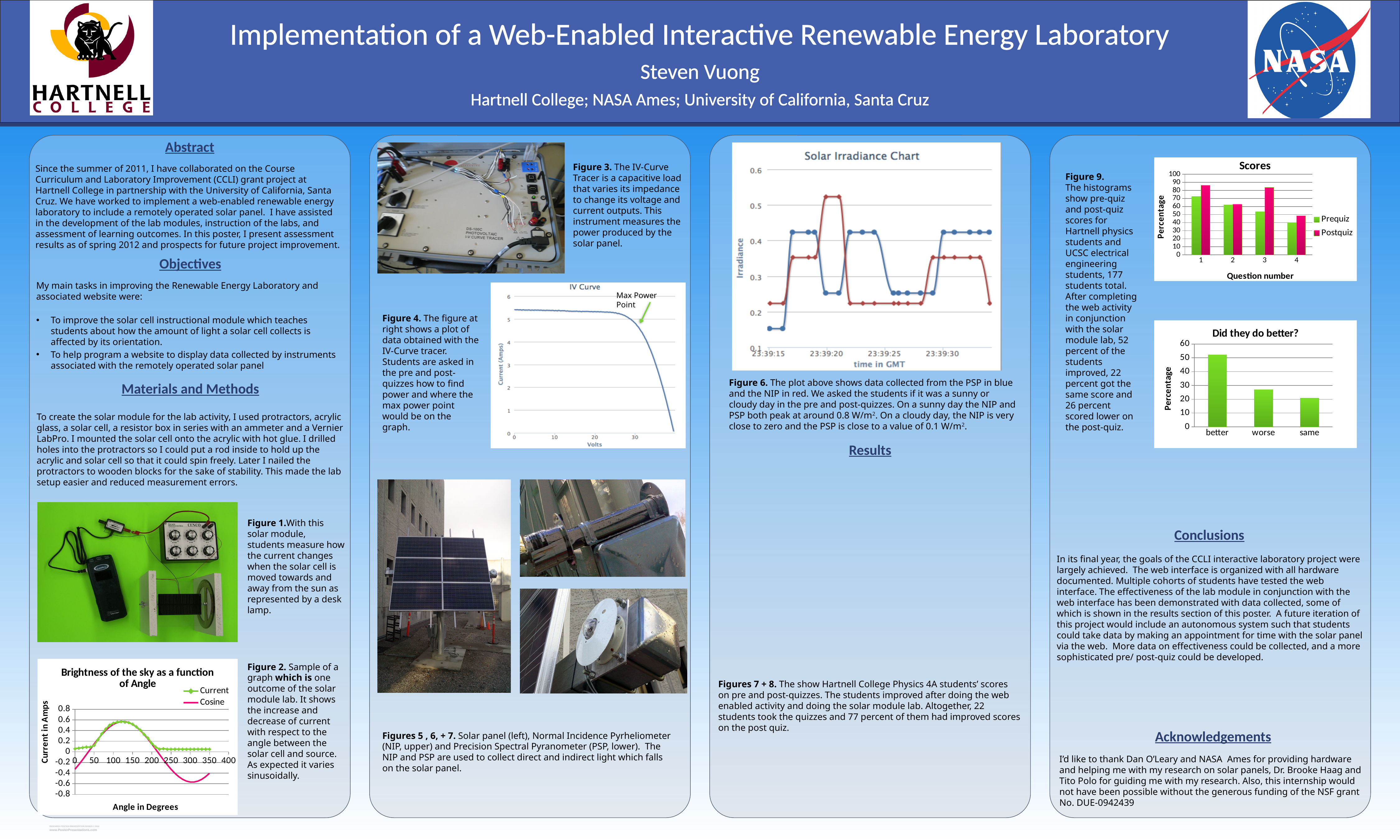
How many categories are shown in the "Did they do better?" chart? 3 How many series does the legend of the "Brightness of the sky as a function of Angle" chart list? 2 What kind of chart is the "Did they do better?" chart? bar chart In the "Scores" chart, which question number has the lowest Prequiz score? 4 In the "Scores" chart, is the Prequiz value for question 4 greater or less than 50? less How many question numbers are shown on the x axis of the "Scores" chart? 4 In the "Did they do better?" chart, is the value for "same" greater or less than 30? less In the "Scores" chart, for question 1, which is larger, Prequiz or Postquiz? Postquiz In the "Did they do better?" chart, is the value for "better" greater or less than 40? greater In the "Did they do better?" chart, which category has the highest percentage? better How many series does the legend of the "Scores" chart list? 2 In the "Did they do better?" chart, which category has the lowest percentage? same